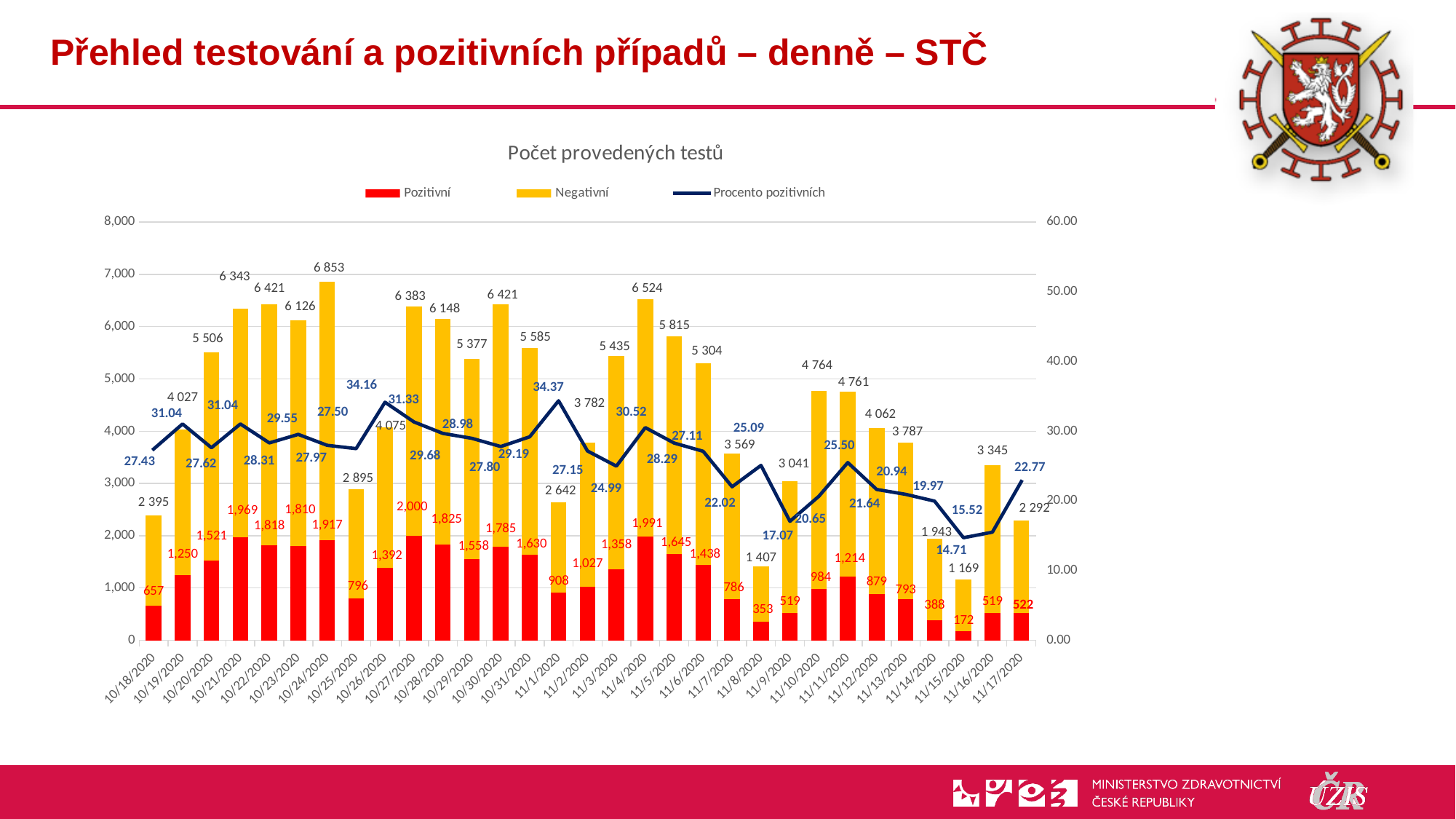
What is the Pozitivní value for 10/27/2020? 2,000 How many dates are shown on the x axis? 31 On which date is the total number of tests the highest? 10/24/2020 What is the total number of tests labelled for 10/24/2020? 6 853 What is the difference between the total tests on 10/24/2020 and 10/25/2020? 3 958 How many series does the legend list? 3 On which date is the total number of tests the lowest? 11/15/2020 Which date has a larger Pozitivní value, 11/4/2020 or 11/5/2020? 11/4/2020 On which date is the Pozitivní value the lowest? 11/15/2020 What type of chart is shown on the slide? Bar chart with a line What is the title of the chart? Počet provedených testů What is the Procento pozitivních value for 11/15/2020? 14.71